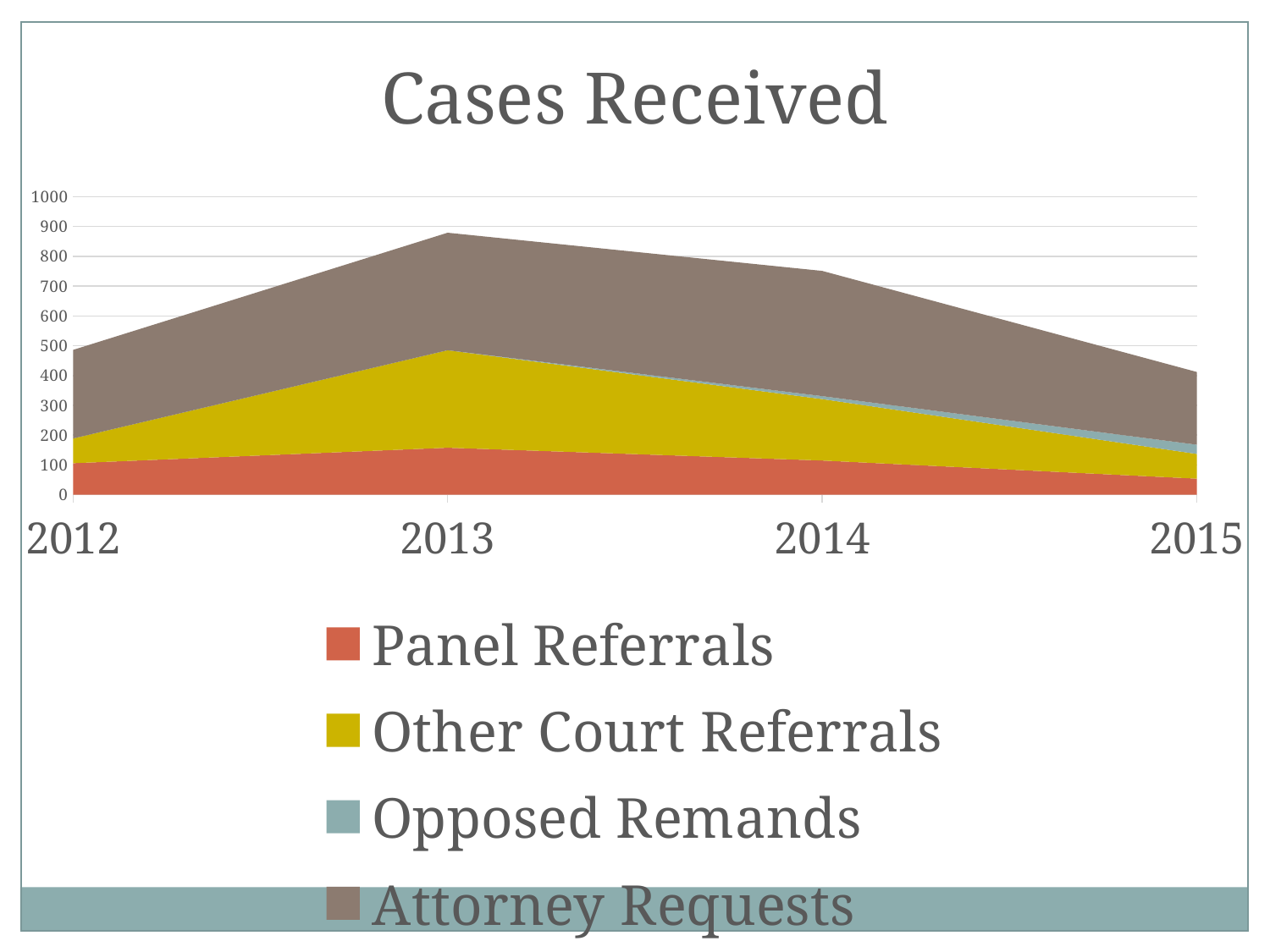
What kind of chart is shown on the slide? Stacked area chart In which year is the total of all stacked series highest? 2013 How many series does the legend list? 4 Is the value for Panel Referrals in 2015 greater or less than 100? less How many years are plotted along the x axis? 4 Is the total stacked value for 2014 greater or less than 700? greater What is the title of the chart? Cases Received Which series is shown in the topmost (brown) band of the chart? Attorney Requests Is the total stacked value for 2015 greater or less than 300? greater How does the total of cases received change from 2013 to 2015? It falls In which year is the total of all stacked series lowest? 2015